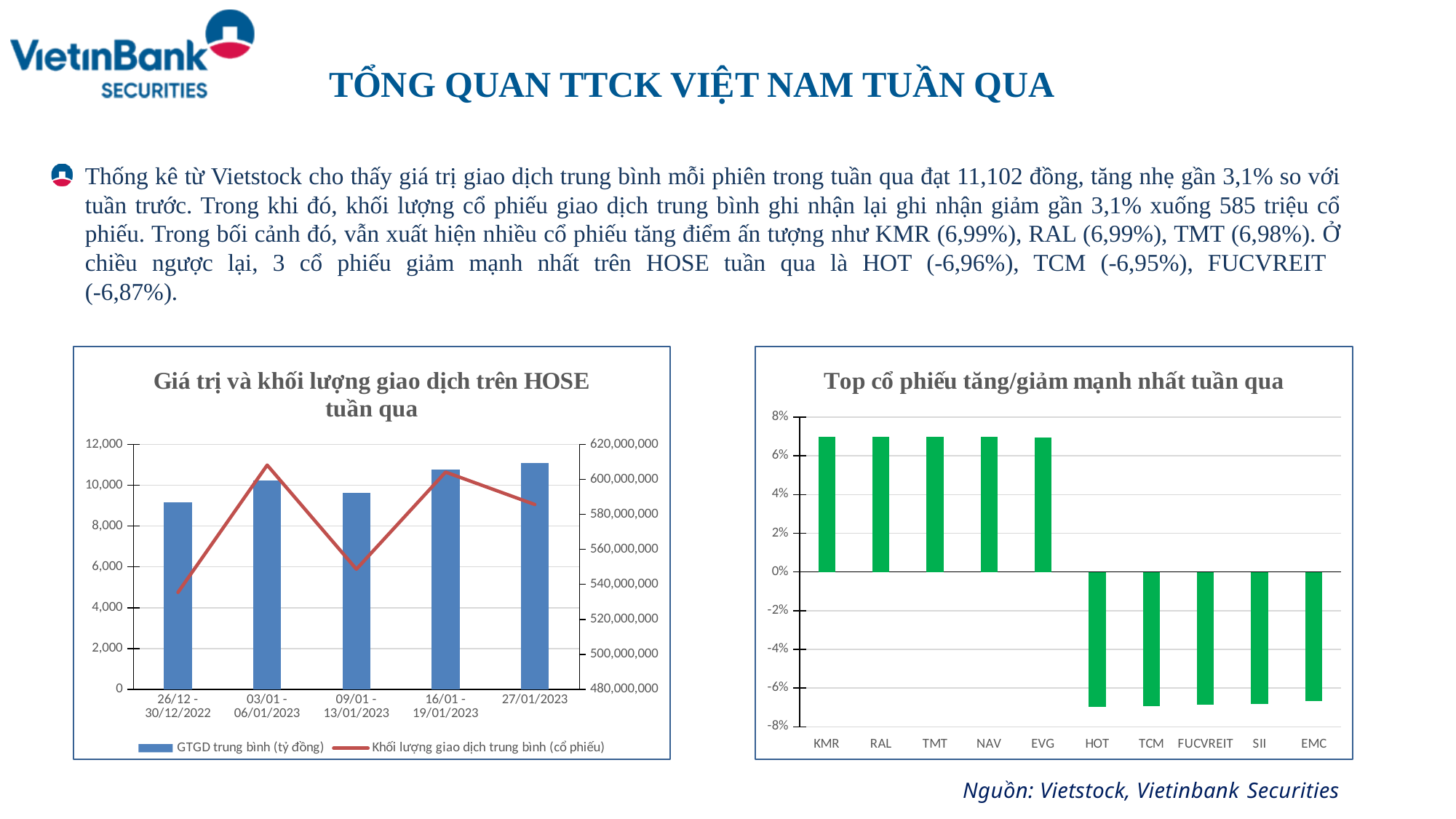
In the left chart 'Giá trị và khối lượng giao dịch trên HOSE tuần qua', is the GTGD trung bình bar for 27/01/2023 greater or less than 10,000? greater How many stocks are shown in the right chart 'Top cổ phiếu tăng/giảm mạnh nhất tuần qua'? 10 How many series does the legend of the left chart 'Giá trị và khối lượng giao dịch trên HOSE tuần qua' list? 2 What kind of chart is the right chart, 'Top cổ phiếu tăng/giảm mạnh nhất tuần qua'? Bar chart In the left chart 'Giá trị và khối lượng giao dịch trên HOSE tuần qua', which period has a larger GTGD trung bình bar: 03/01 - 06/01/2023 or 09/01 - 13/01/2023? 03/01 - 06/01/2023 What kind of chart is the left chart, 'Giá trị và khối lượng giao dịch trên HOSE tuần qua'? A bar chart combined with a line In the left chart 'Giá trị và khối lượng giao dịch trên HOSE tuần qua', is the Khối lượng giao dịch trung bình value for 26/12 - 30/12/2022 greater or less than 560,000,000? less In the left chart 'Giá trị và khối lượng giao dịch trên HOSE tuần qua', what is the name of the series plotted as a line? Khối lượng giao dịch trung bình (cổ phiếu) In the right chart 'Top cổ phiếu tăng/giảm mạnh nhất tuần qua', is the value for KMR greater or less than 6%? greater In the left chart 'Giá trị và khối lượng giao dịch trên HOSE tuần qua', which period has the shortest bar for GTGD trung bình (tỷ đồng)? 26/12 - 30/12/2022 In the left chart 'Giá trị và khối lượng giao dịch trên HOSE tuần qua', which period has the tallest bar for GTGD trung bình (tỷ đồng)? 27/01/2023 In the left chart 'Giá trị và khối lượng giao dịch trên HOSE tuần qua', how many time periods are shown on the x axis? 5